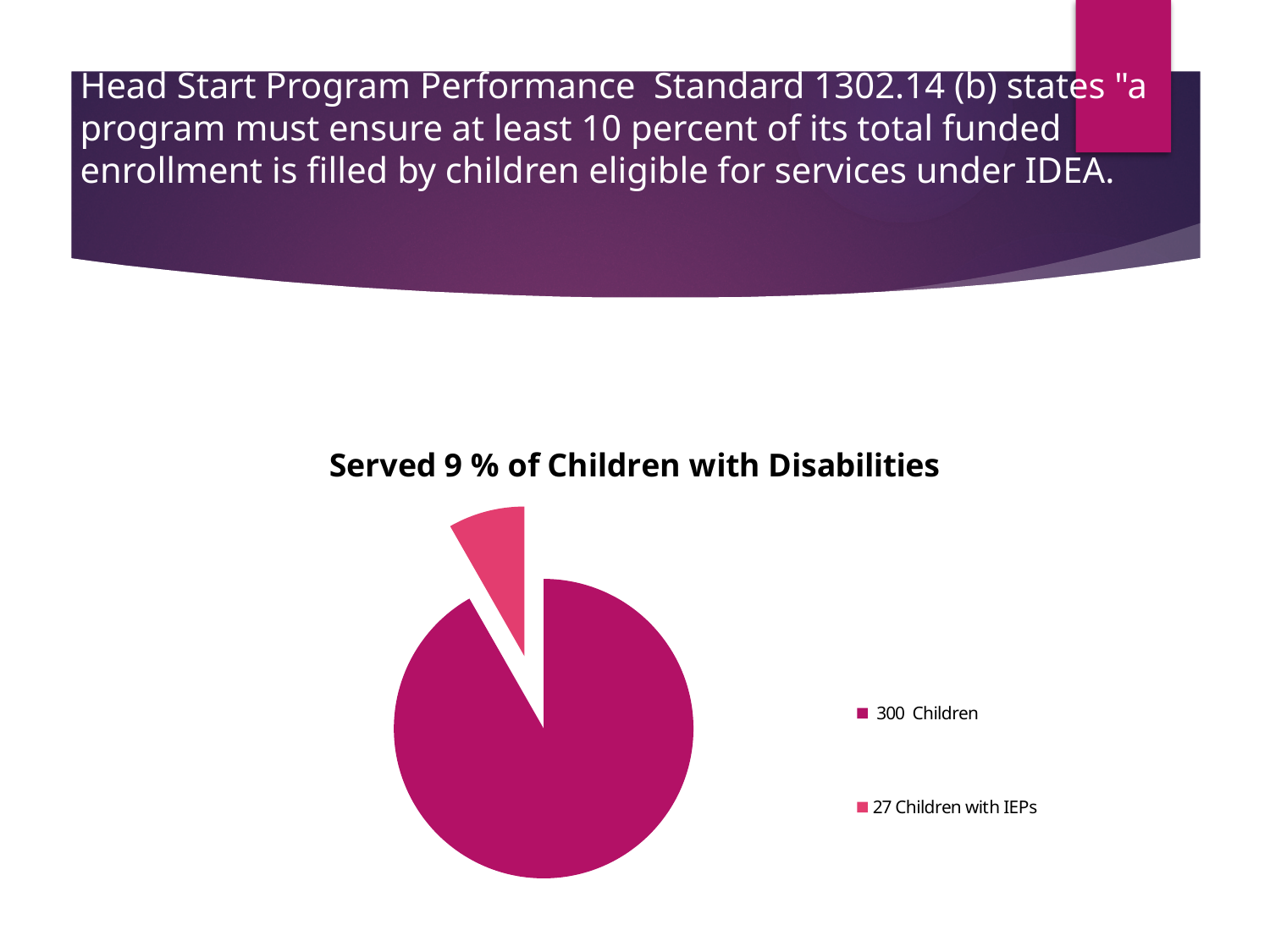
Which slice of the pie chart is the smallest? 27 Children with IEPs How many entries does the legend of the pie chart list? 2 Which is larger in the pie chart: the '300 Children' slice or the '27 Children with IEPs' slice? 300 Children What kind of chart is shown on the slide? pie chart How many slices does the pie chart have? 2 Which legend entry of the pie chart is shown in the lighter pink colour? 27 Children with IEPs Which slice of the pie chart is the largest? 300 Children What is the title of the pie chart? Served 9 % of Children with Disabilities